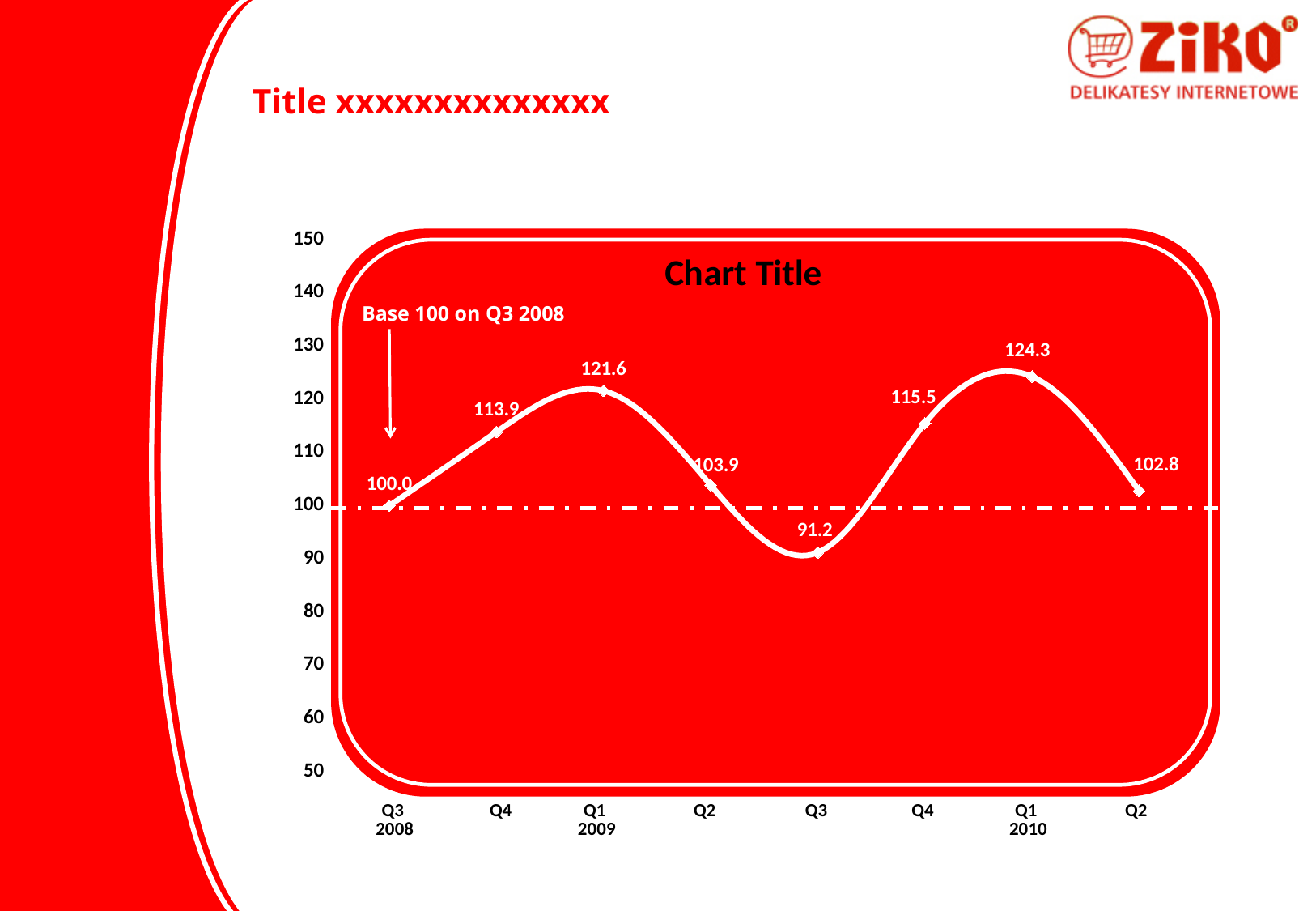
What is the value for Q3 2008? 100.0 What is the difference between the values for Q1 2010 and Q3 2009? 33.1 What is the value for Q3 2009? 91.2 What is the value for Q2 2010? 102.8 Is the value for Q2 2009 greater or less than 100? greater How many data points are plotted on the chart? 8 What does the annotation with the arrow on the chart say? Base 100 on Q3 2008 What is the value for Q1 2009? 121.6 What kind of chart is shown on the slide? line chart Which quarter has the highest value? Q1 2010 Which is larger, the value for Q4 2008 or the value for Q4 2009? Q4 2009 Which quarter has the lowest value? Q3 2009